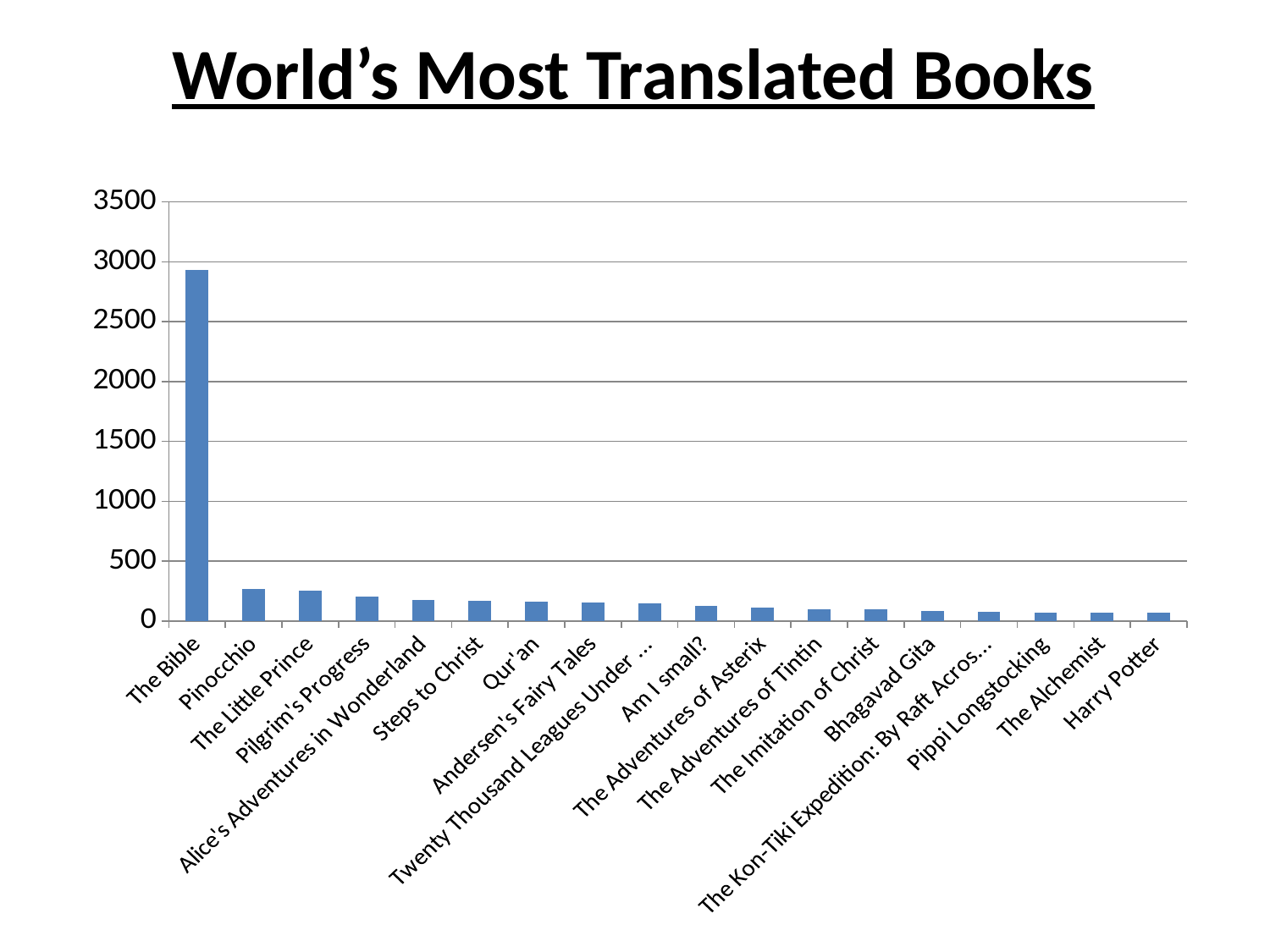
Do the values generally rise or fall moving from left to right along the x axis? fall Which has a larger value, The Bible or Pinocchio? The Bible Is the value for The Bible greater or less than 2500? greater Which has a larger value, Pinocchio or Harry Potter? Pinocchio How many books are shown on the x axis of the chart? 18 What is the title of the chart? World's Most Translated Books Is the value for Pinocchio greater or less than 500? less What kind of chart is shown on the slide? bar chart Is the value for Harry Potter greater or less than 500? less What colour are the bars in the chart? blue Which book has the highest value in the chart? The Bible